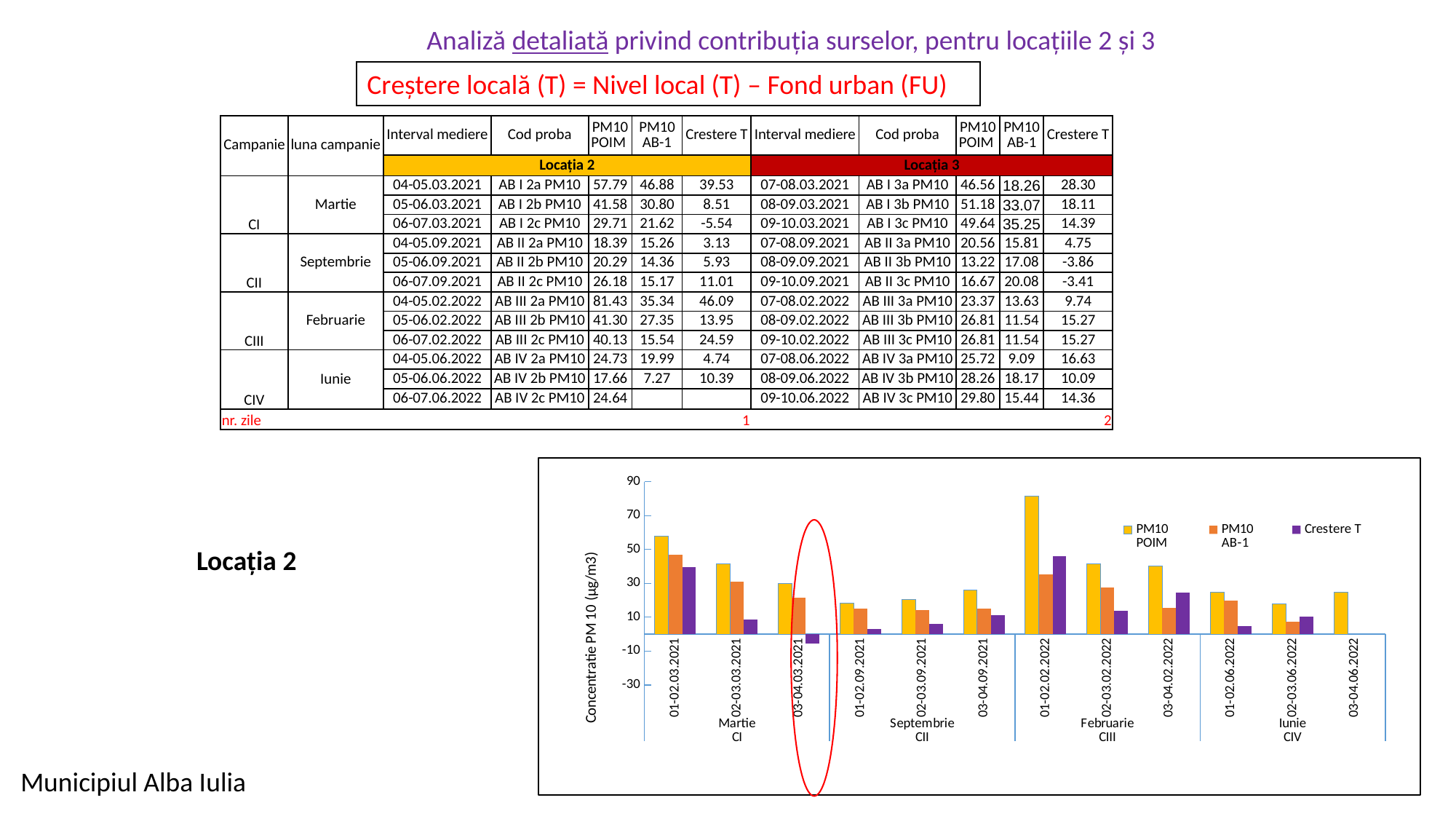
Which date category has the highest PM10 POIM bar? 01-02.02.2022 Is the PM10 POIM value for 01-02.02.2022 greater or less than 70? greater Is the PM10 POIM value for 01-02.03.2021 greater or less than 50? greater Which date category has the lowest Crestere T bar? 03-04.03.2021 What is the title of the chart's vertical axis? Concentratie PM 10 (µg/m3) How many date categories are shown along the x axis of the chart? 12 Do the PM10 POIM bars rise or fall across the three March 2021 (Martie CI) dates? fall Which is larger, the PM10 POIM value for 01-02.03.2021 or for 02-03.03.2021? 01-02.03.2021 Is the PM10 AB-1 value for 02-03.06.2022 greater or less than 10? less What kind of chart is shown on the slide? bar chart How many series does the chart legend list? 3